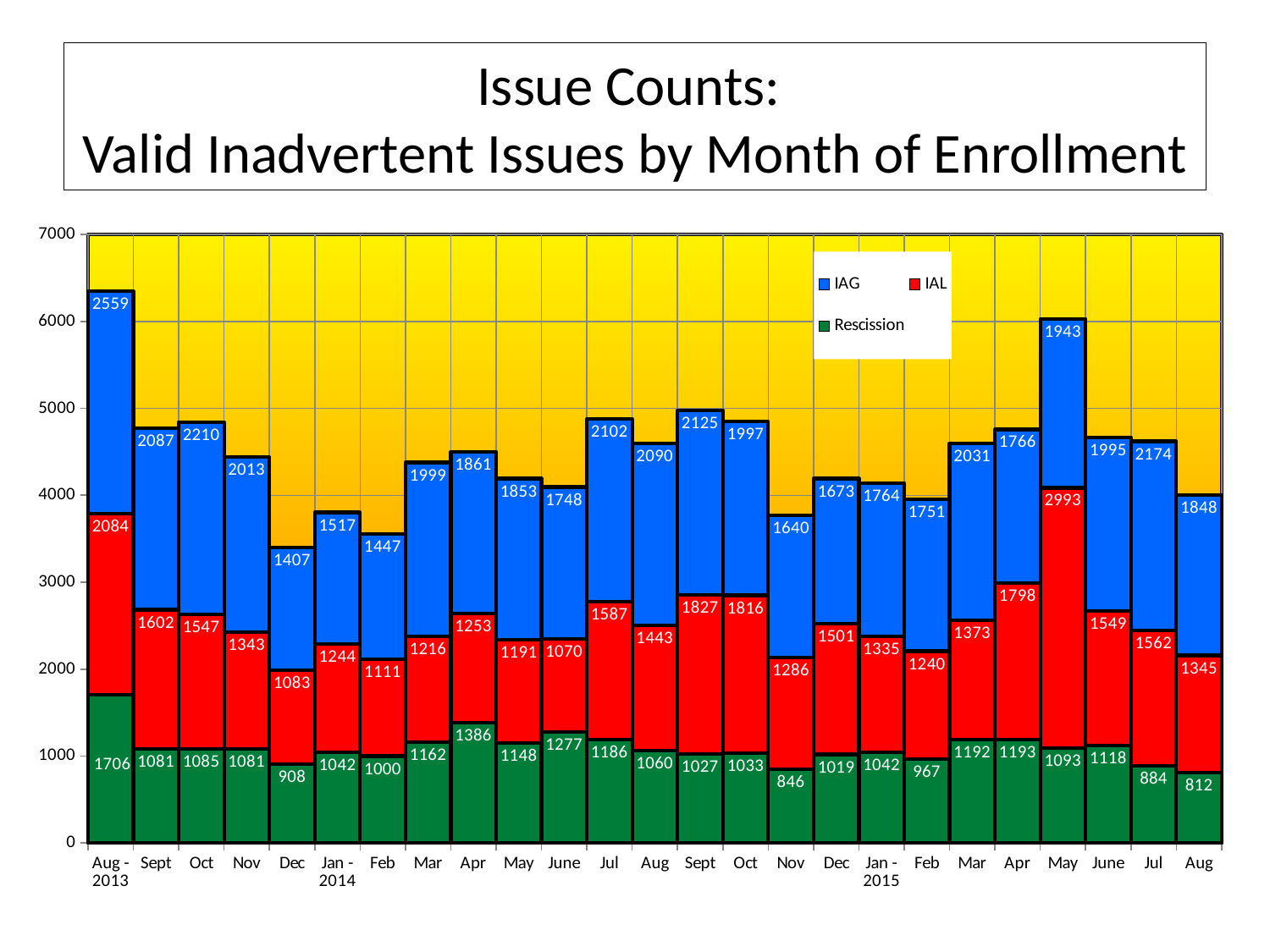
What is the Rescission value for Apr 2014? 1386 What is the difference between the IAG value for Aug 2013 and the IAG value for Sept 2013? 472 Which month has the highest IAL value? May 2015 How many series does the legend list? 3 Which is larger, the IAL value for Sept 2014 or the IAL value for Oct 2014? Sept 2014 Which month has the lowest IAG value? Dec 2013 How many months are shown on the x axis? 25 What is the IAG value for Aug 2013? 2559 What kind of chart is shown on the slide? Stacked bar chart What is the total of the stacked bar for Aug 2013? 6349 Which month has the lowest Rescission value? Aug 2015 What is the IAL value for May 2015? 2993